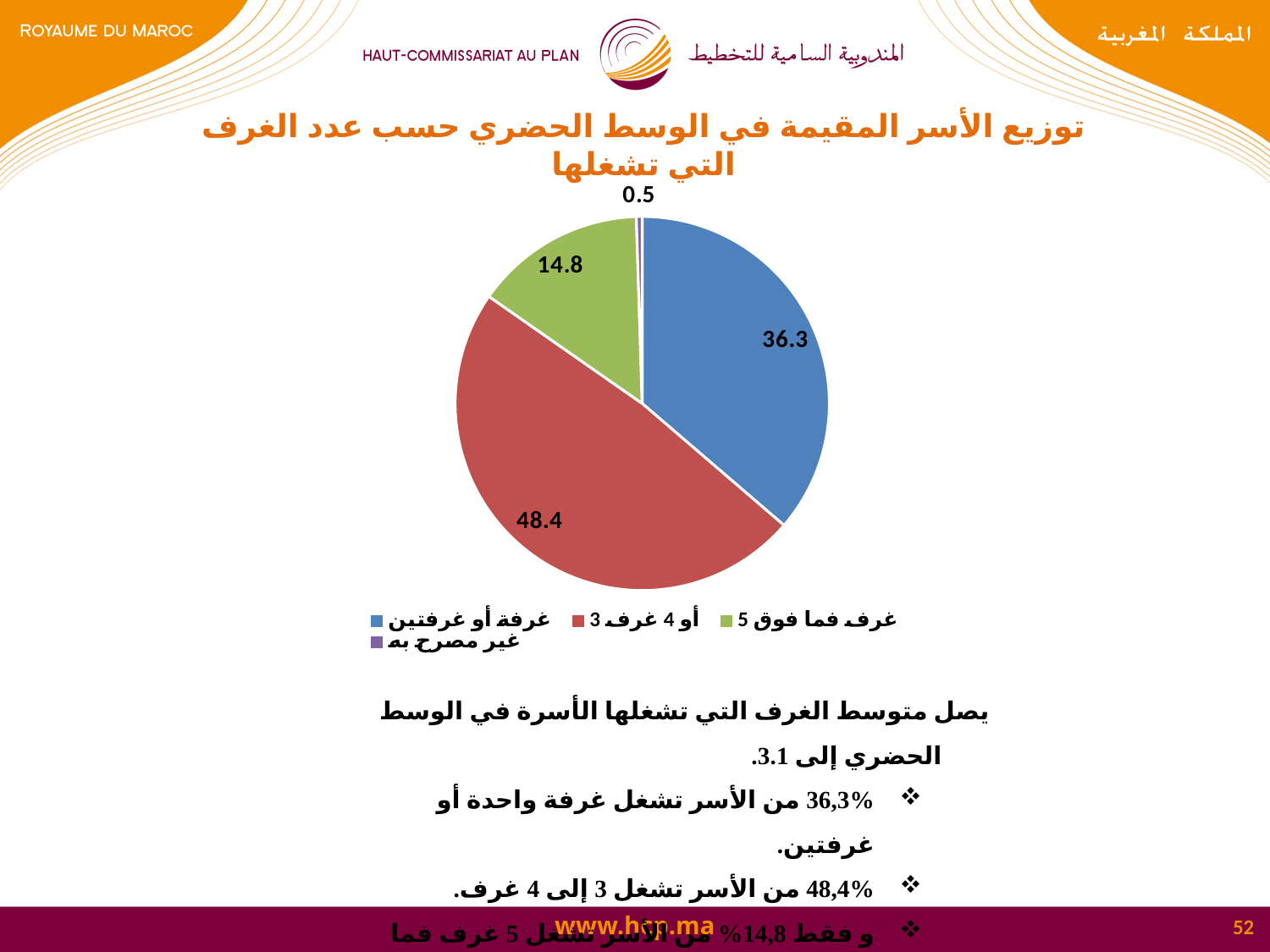
What colour is the slice for "3 أو 4 غرف"? red Which is larger, the slice for "غرفة أو غرفتين" or the slice for "5 غرف فما فوق"? غرفة أو غرفتين What is the value for the slice labelled "غرفة أو غرفتين" (one or two rooms)? 36.3 Which category has the largest slice of the pie? 3 أو 4 غرف Which category has the smallest slice of the pie? غير مصرح به How many slices does the pie chart have? 4 What is the difference between the values for "3 أو 4 غرف" and "غرفة أو غرفتين"? 12.1 What type of chart is shown on the slide? pie chart What is the value for the slice labelled "3 أو 4 غرف" (3 or 4 rooms)? 48.4 How many entries does the legend list? 4 What is the value for the slice labelled "غير مصرح به" (not declared)? 0.5 What is the value for the slice labelled "5 غرف فما فوق" (5 rooms or more)? 14.8